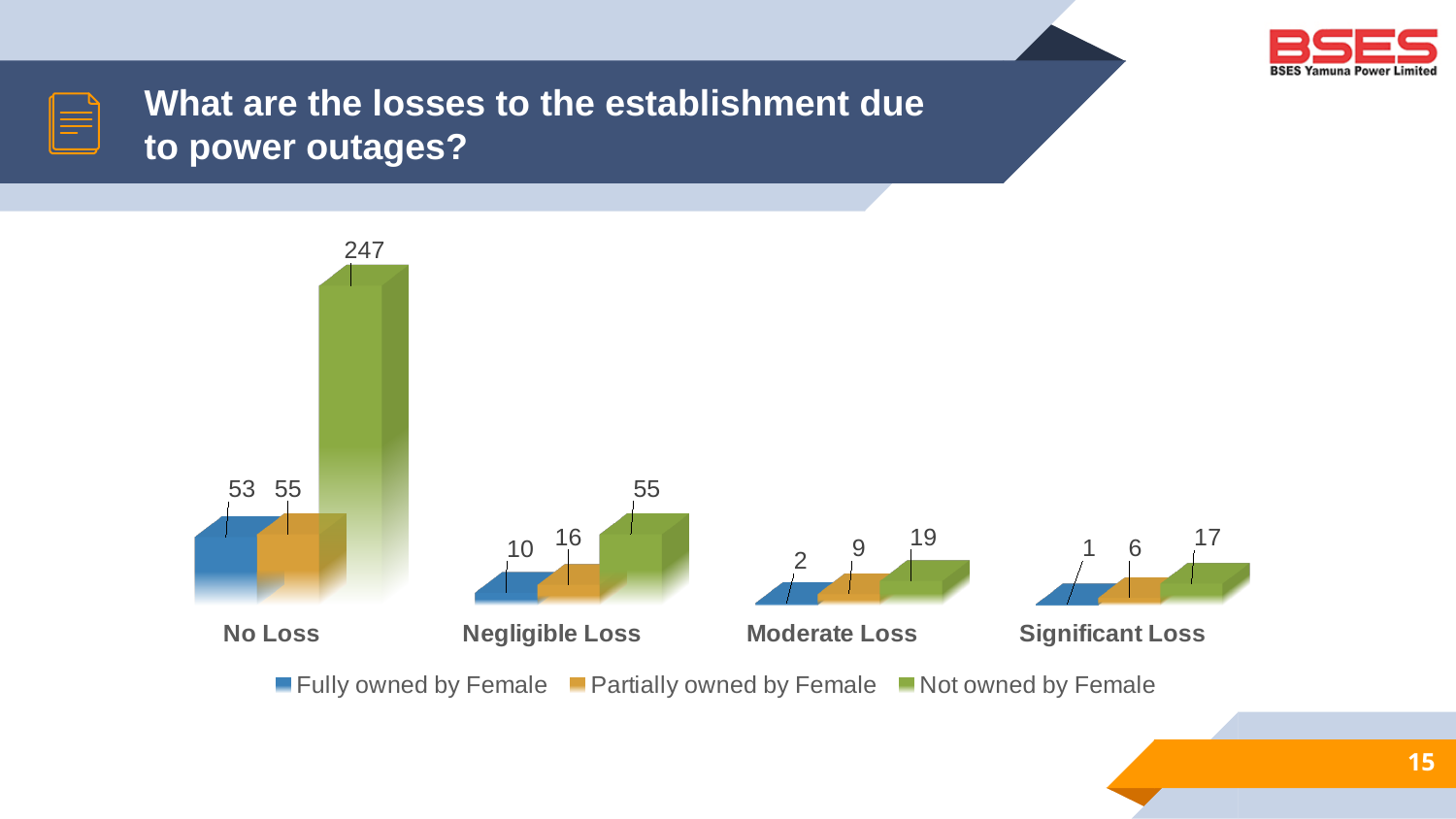
Which category has the highest value for Not owned by Female? No Loss Which series is shown in green in the legend? Not owned by Female What is the value for Partially owned by Female in the Moderate Loss category? 9 Which is larger in the Negligible Loss category: Partially owned by Female or Fully owned by Female? Partially owned by Female How many categories are shown on the x axis? 4 What is the value for Fully owned by Female in the Significant Loss category? 1 What is the difference between the Not owned by Female and Partially owned by Female values in the No Loss category? 192 What is the value for Fully owned by Female in the Negligible Loss category? 10 What is the value for Not owned by Female in the No Loss category? 247 How many series does the legend list? 3 What kind of chart is shown on the slide? Bar chart Which category has the lowest value for Fully owned by Female? Significant Loss